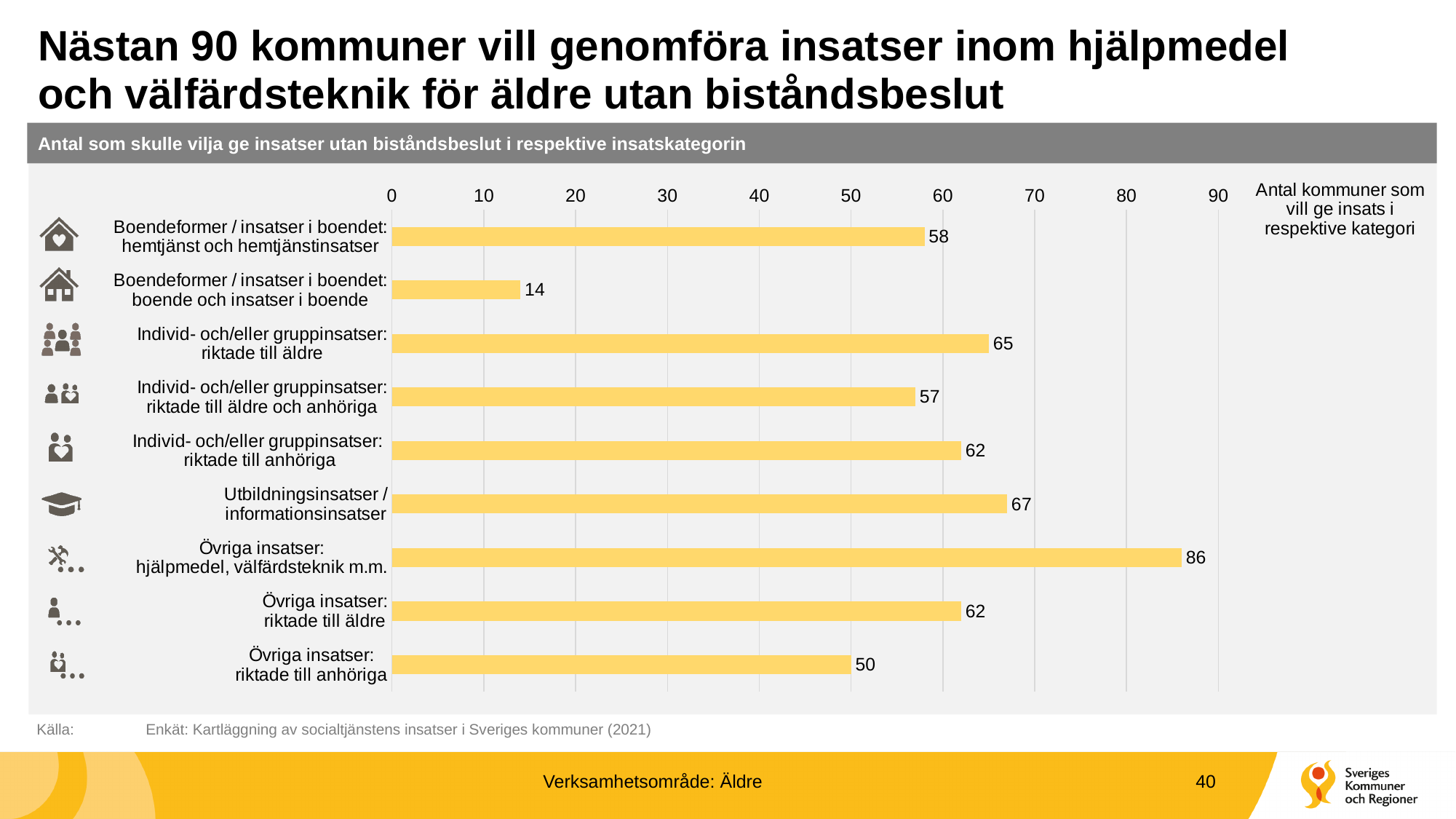
Is the value for 'Boendeformer / insatser i boendet: hemtjänst och hemtjänstinsatser' greater or less than 50? greater How many categories are shown in the chart? 9 What is the value for 'Övriga insatser: hjälpmedel, välfärdsteknik m.m.'? 86 What is the value for 'Utbildningsinsatser / informationsinsatser'? 67 What kind of chart is shown on the slide? Bar chart What is the title of the chart? Antal som skulle vilja ge insatser utan biståndsbeslut i respektive insatskategorin What is the difference between the values for 'Övriga insatser: hjälpmedel, välfärdsteknik m.m.' and 'Utbildningsinsatser / informationsinsatser'? 19 What is the value for 'Övriga insatser: riktade till anhöriga'? 50 Which category has the lowest value? Boendeformer / insatser i boendet: boende och insatser i boende What is the value for 'Boendeformer / insatser i boendet: boende och insatser i boende'? 14 Which category has the highest value? Övriga insatser: hjälpmedel, välfärdsteknik m.m. Which is larger: the value for 'Individ- och/eller gruppinsatser: riktade till äldre' or 'Individ- och/eller gruppinsatser: riktade till äldre och anhöriga'? Individ- och/eller gruppinsatser: riktade till äldre